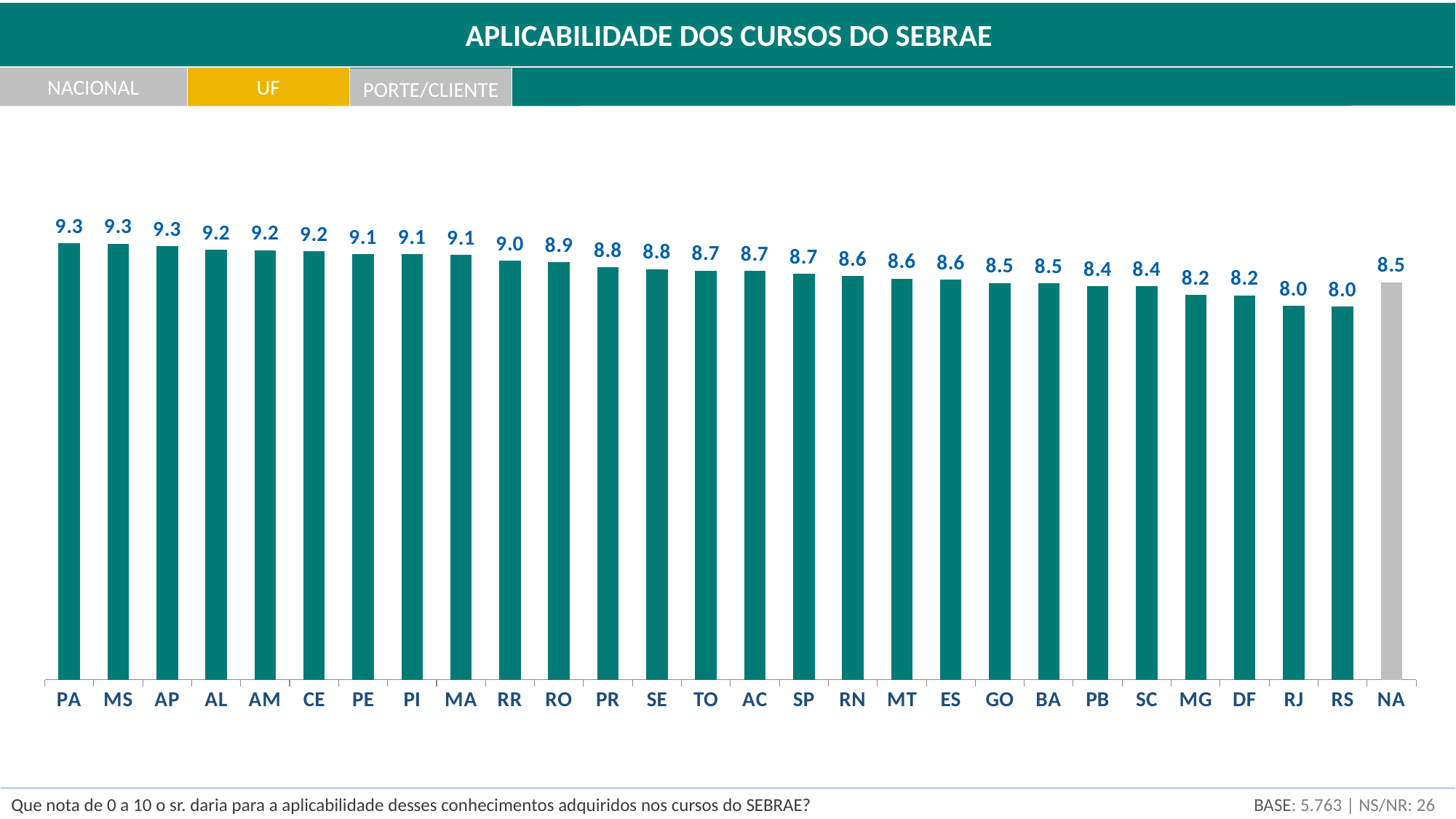
What is the value for NA? 8.5 What kind of chart is shown on the slide? Bar chart What is the value for MG? 8.2 Which has a larger value, CE or GO? CE What is the difference between the values for RO and DF? 0.7 What is the lowest value shown on the chart? 8.0 How many categories are shown on the x axis? 28 What is the value for RR? 9.0 What is the title of the chart? APLICABILIDADE DOS CURSOS DO SEBRAE What is the difference between the values for PA and RS? 1.3 What is the highest value shown on the chart? 9.3 What is the value for SP? 8.7